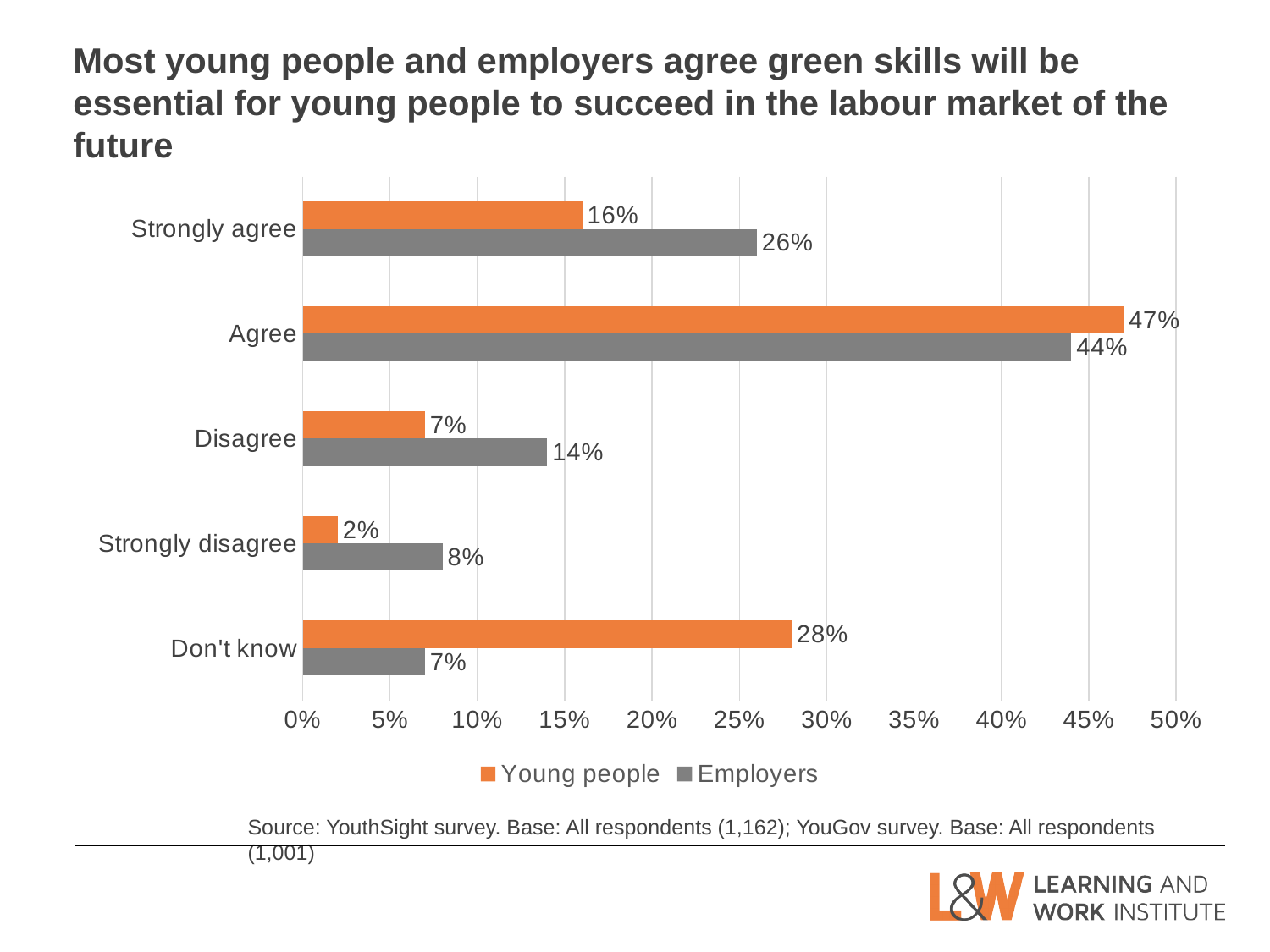
What kind of chart is shown on the slide? Bar chart For 'Don't know', which group has the larger value, young people or employers? Young people What percentage of employers agree? 44% Which response category has the lowest value for employers? Don't know Which colour represents employers in the chart? Grey Which response category has the highest value for young people? Agree How many response categories are shown on the chart? 5 What is the difference between the young people's values for 'Agree' and 'Disagree'? 40% How many series does the legend list? 2 What percentage of young people strongly agree? 16% What is the difference between the employers' and young people's values for 'Strongly agree'? 10% What percentage of employers answered 'Don't know'? 7%